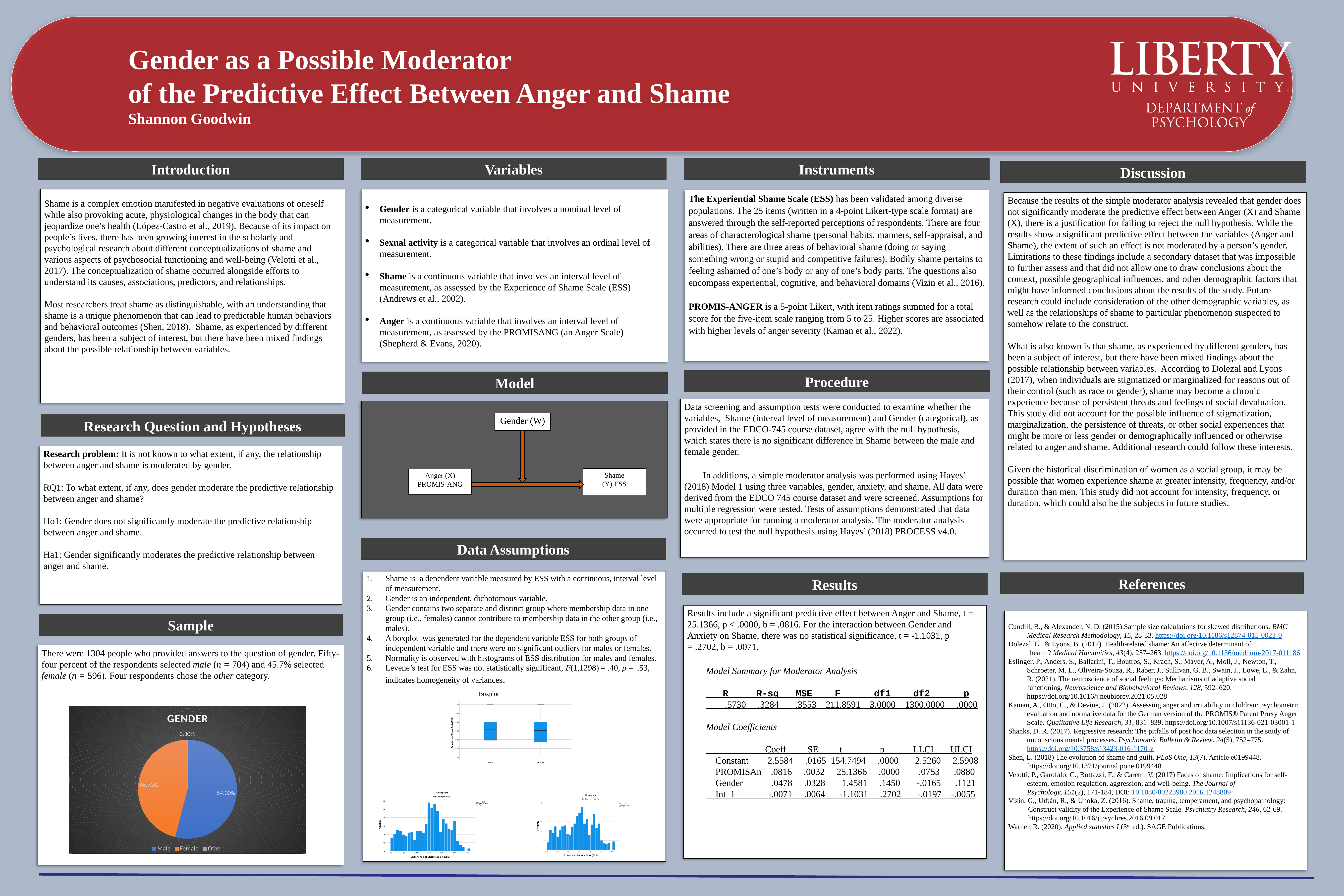
What is the title of the pie chart in the Sample section? GENDER In the GENDER pie chart, which category has the largest slice? Male What kind of chart is the GENDER chart in the Sample section? pie chart In the GENDER pie chart, which slice is larger, Male or Female? Male In the GENDER pie chart, what share of respondents is labelled Female? 45.70% In the GENDER pie chart, what share of respondents is labelled Male? 54.00% How many categories does the GENDER pie chart show? 3 In the GENDER pie chart, what is the combined share of the Male and Female slices? 99.70% In the GENDER pie chart, what colour is the Female slice? orange In the GENDER pie chart, what is the difference in percentage points between the Male and Female slices? 8.30 In the GENDER pie chart, which category has the smallest slice? Other In the GENDER pie chart, what share of respondents is labelled Other? 0.30%